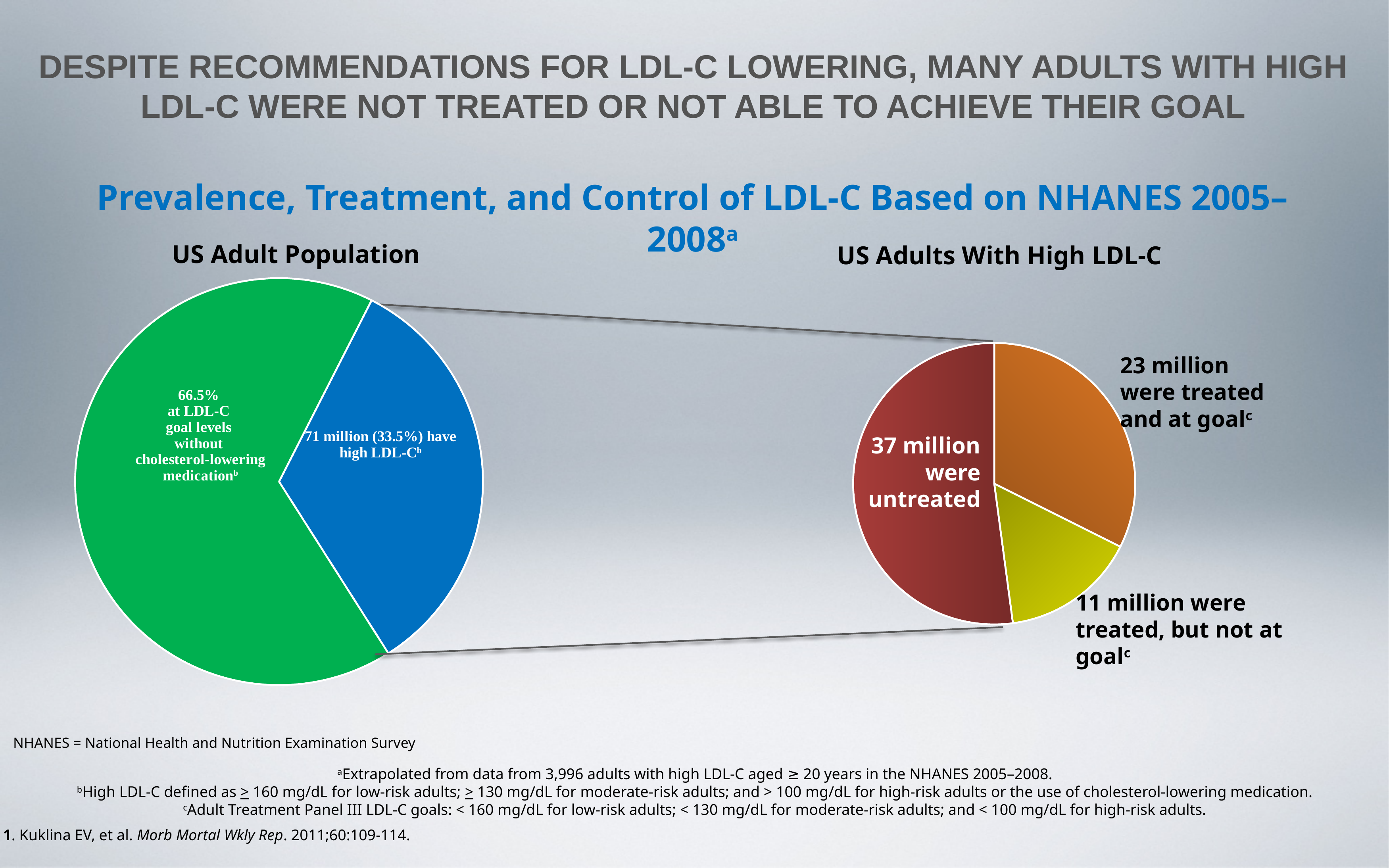
In the US Adult Population chart, how many adults have high LDL-C? 71 million In the US Adults With High LDL-C chart, how many adults were treated and at goal? 23 million What kind of chart is used for the US Adult Population? Pie chart In the US Adult Population chart, how many slices does the pie have? 2 In the US Adult Population chart, what percentage of adults are at LDL-C goal levels without cholesterol-lowering medication? 66.5% In the US Adults With High LDL-C chart, which group is the largest? Untreated (37 million) In the US Adults With High LDL-C chart, what is the difference between the number untreated and the number treated and at goal? 14 million In the US Adults With High LDL-C chart, what is the total of the three groups? 71 million In the US Adults With High LDL-C chart, how many adults were treated but not at goal? 11 million In the US Adult Population chart, what share of the pie do adults with high LDL-C represent? 33.5% In the US Adults With High LDL-C chart, how many adults were untreated? 37 million In the US Adults With High LDL-C chart, which group is the smallest? Treated, but not at goal (11 million)